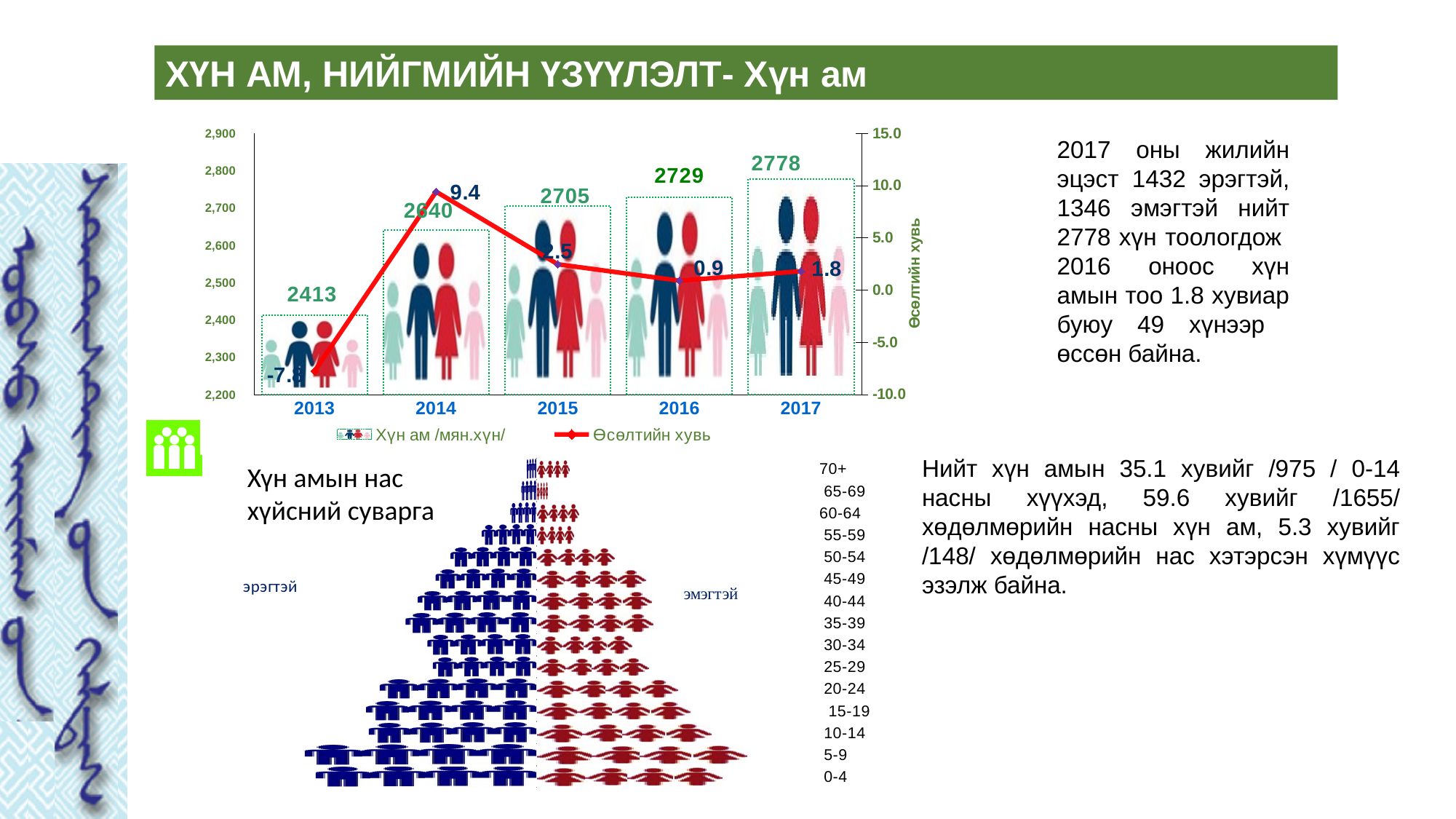
In the top chart, what is the difference between the population values for 2017 and 2016? 49 What is the title of the bottom chart on the slide? Хүн амын нас хүйсний суварга In the top chart, is the growth rate for 2015 larger or smaller than the growth rate for 2017? larger In the top chart, which year has the highest growth rate (Өсөлтийн хувь)? 2014 In the top chart, what is the growth rate (Өсөлтийн хувь) for 2016? 0.9 In the top chart, how many series does the legend list? 2 In the top chart, how many years are shown on the x axis? 5 In the top chart, which year has the lowest population value (Хүн ам)? 2013 In the top chart, does the population value (Хүн ам) rise or fall from 2013 to 2017? rise In the top chart, what is the population value (Хүн ам) for 2013? 2413 In the top chart, what is the growth rate (Өсөлтийн хувь) for 2014? 9.4 In the top chart, what is the population value (Хүн ам) for 2017? 2778